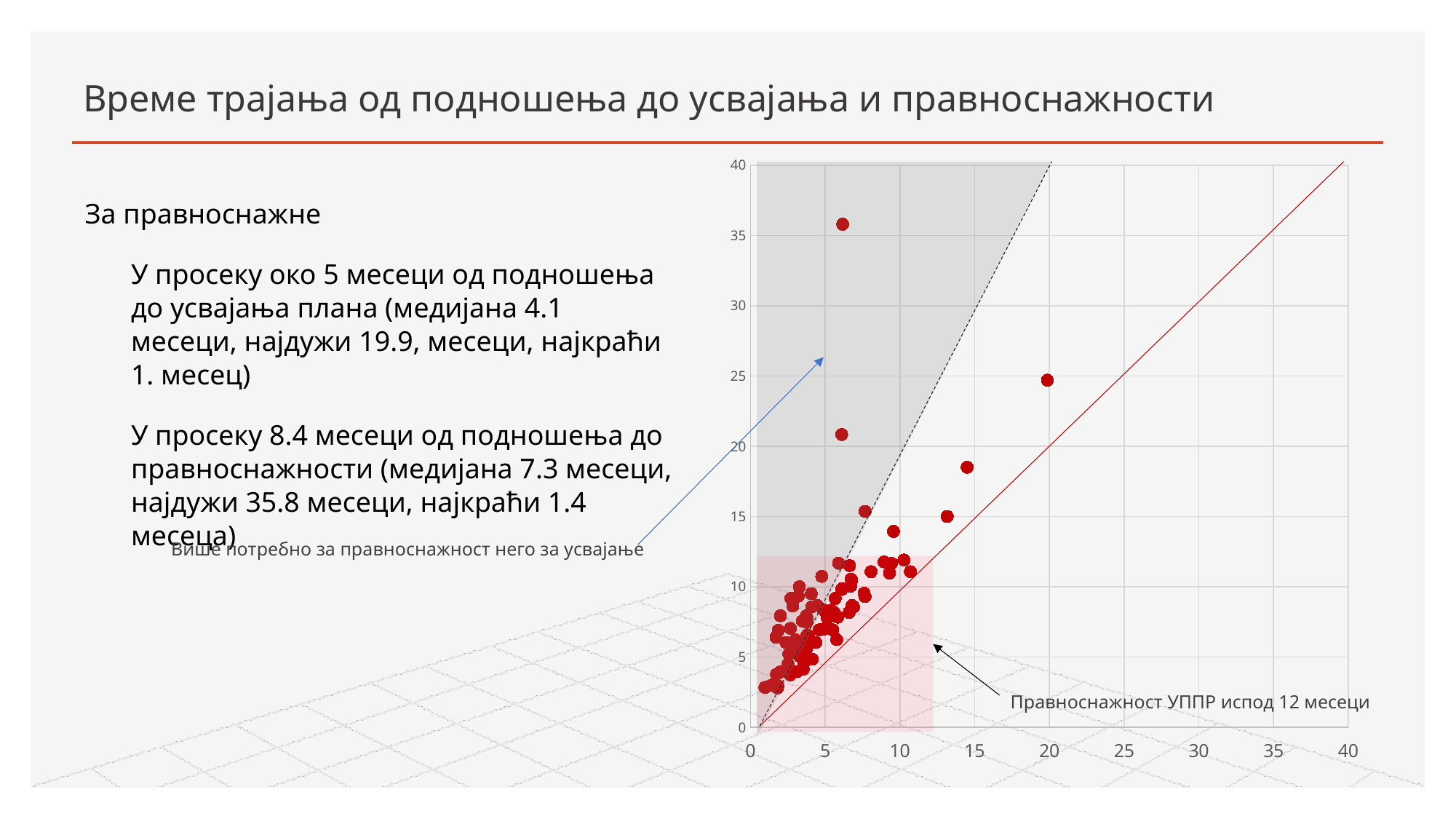
Is the vertical-axis value of the point near 15 on the horizontal axis greater or less than 20? less Are most of the plotted points located below or above 15 on the vertical axis? below Is the vertical-axis value of the point located furthest to the right (near 20 on the horizontal axis) greater or less than 20? greater What is the highest value shown on the vertical axis of the chart? 40 What kind of chart is shown on the slide? scatter chart What is the highest value shown on the horizontal axis of the chart? 40 Do the plotted points generally rise or fall as the horizontal-axis value increases? rise